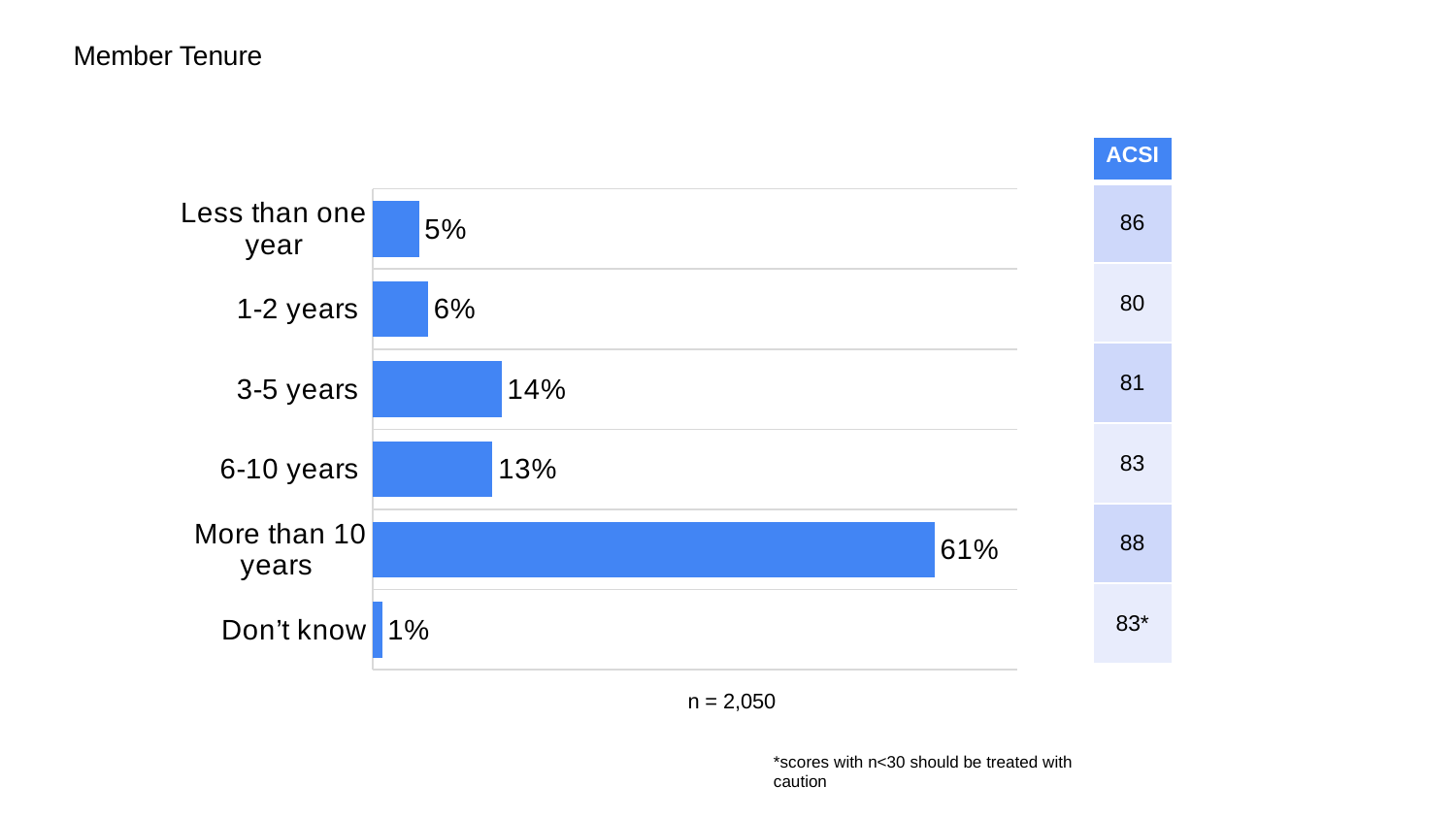
Which category has a larger share of members: 1-2 years or 6-10 years? 6-10 years What is the difference in percentage points between the 'More than 10 years' and '1-2 years' categories? 55% What percentage of members have been members for less than one year? 5% What percentage of members have been members for more than 10 years? 61% What type of chart is used to show member tenure? Bar chart Which tenure category has the highest percentage of members? More than 10 years What percentage of members have a tenure of 3-5 years? 14% What is the sample size (n) shown below the chart? 2,050 What is the difference in percentage points between the 3-5 years and 6-10 years categories? 1% What percentage of members answered 'Don't know' about their tenure? 1% How many tenure categories are shown in the chart? 6 Which tenure category has the lowest percentage of members? Don't know